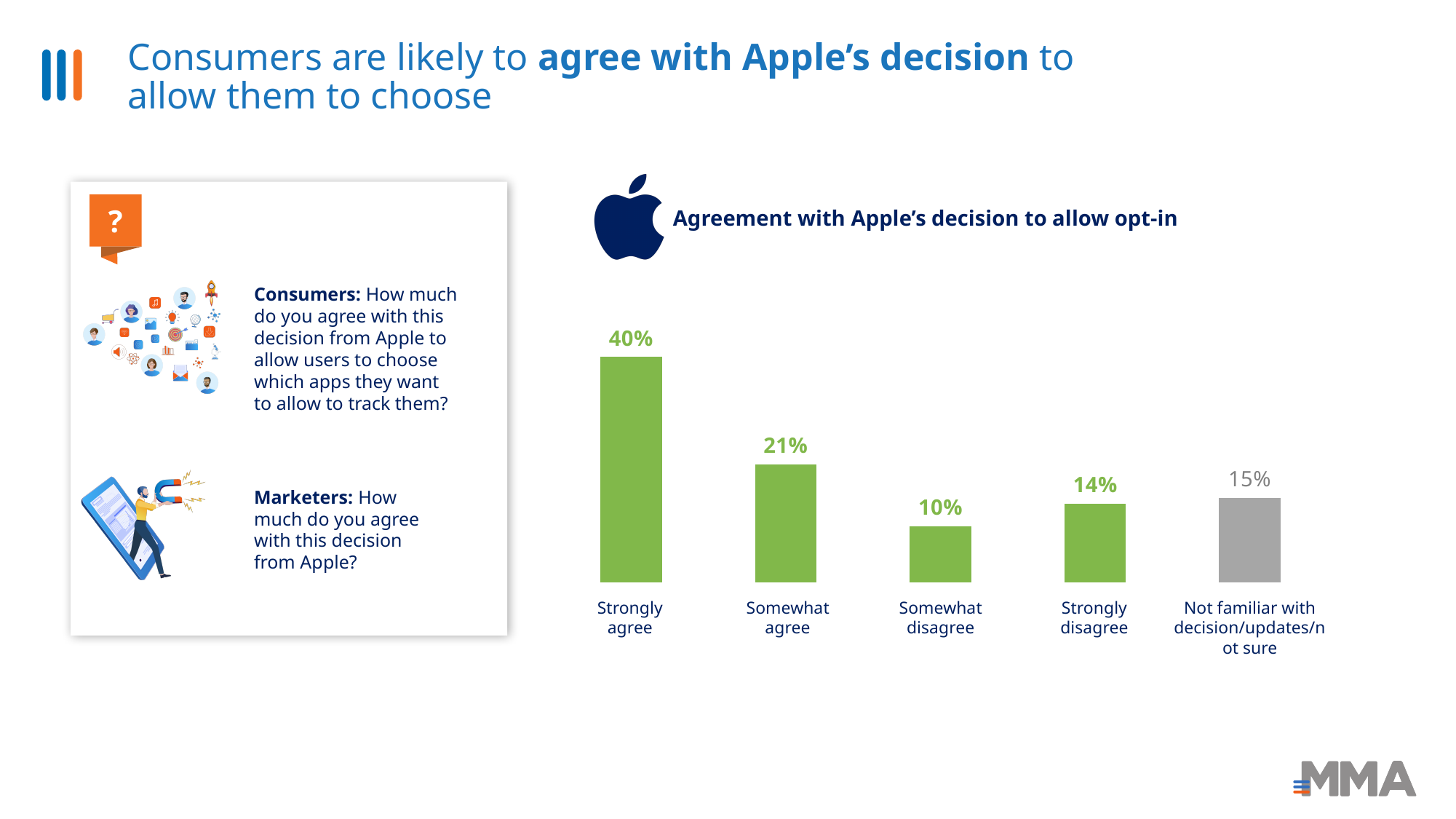
Which category has the highest value? Strongly agree What is the value for Somewhat agree? 21% Which category has the lowest value? Somewhat disagree What is the value for Strongly disagree? 14% What is the title of the chart? Agreement with Apple's decision to allow opt-in What kind of chart is shown? Bar chart Which is larger, Strongly disagree or Somewhat disagree? Strongly disagree How many categories are shown in the chart? 5 What is the difference between Strongly agree and Somewhat agree? 19% What is the value for Somewhat disagree? 10% What is the value for Not familiar with decision/updates/not sure? 15% What is the value for Strongly agree? 40%